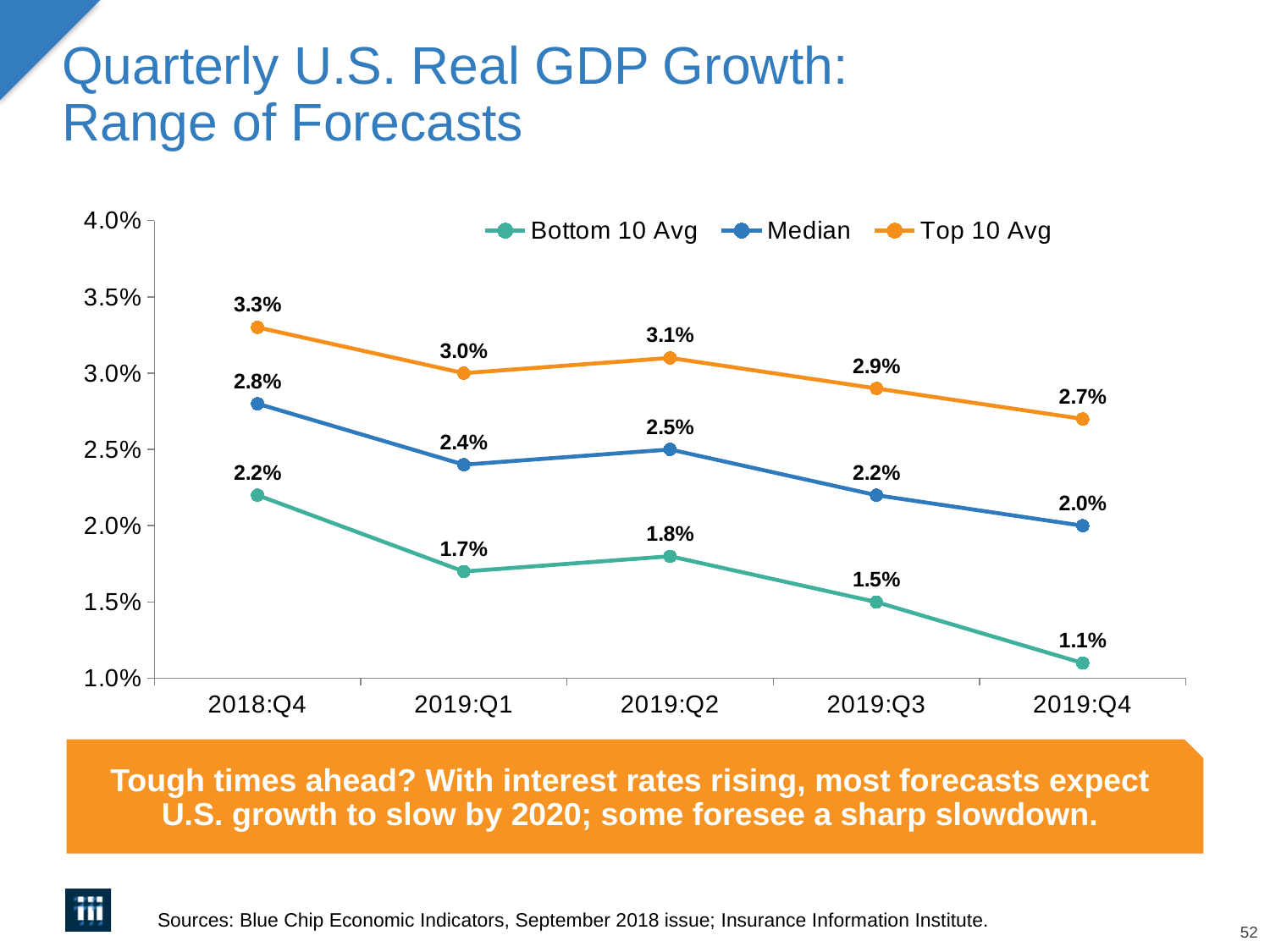
Does the Median forecast generally rise or fall from 2018:Q4 to 2019:Q4? Fall What is the Top 10 Avg forecast for 2018:Q4? 3.3% What is the Median forecast for 2019:Q2? 2.5% What is the difference between the Top 10 Avg and Bottom 10 Avg forecasts for 2019:Q4? 1.6% In which quarter is the Bottom 10 Avg forecast lowest? 2019:Q4 How many quarters are shown on the x axis? 5 How many series does the legend list? 3 What is the Bottom 10 Avg forecast for 2019:Q4? 1.1% In which quarter is the Top 10 Avg forecast highest? 2018:Q4 What kind of chart is shown on the slide? Line chart Which series is drawn in orange? Top 10 Avg Which is larger: the Median forecast for 2019:Q1 or the Median forecast for 2019:Q3? 2019:Q1